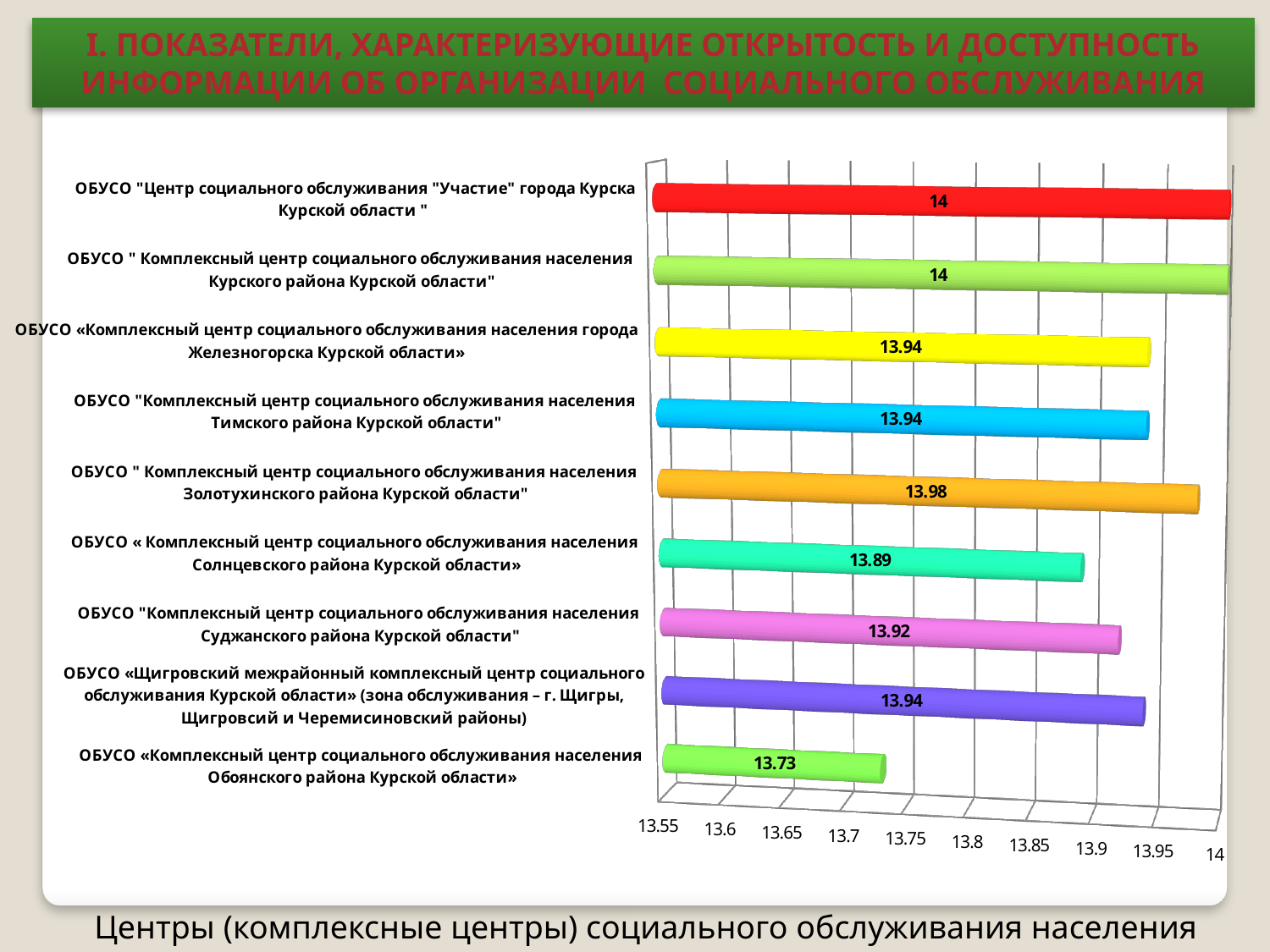
What kind of chart is shown on the slide? Bar chart What is the value for ОБУСО "Комплексный центр социального обслуживания населения Суджанского района Курской области"? 13.92 What is the value for ОБУСО «Комплексный центр социального обслуживания населения Обоянского района Курской области»? 13.73 Which has a larger value: the Золотухинского района centre or the Суджанского района centre? Золотухинского района How many organisations are shown in the chart? 9 What is the value for ОБУСО «Комплексный центр социального обслуживания населения Солнцевского района Курской области»? 13.89 What is the value for ОБУСО "Комплексный центр социального обслуживания населения Золотухинского района Курской области"? 13.98 Is the value for the Солнцевского района centre greater or less than 13.85? greater Which organisation has the lowest value in the chart? ОБУСО «Комплексный центр социального обслуживания населения Обоянского района Курской области» What is the difference between the value for ОБУСО "Центр социального обслуживания "Участие" города Курска Курской области" and the value for ОБУСО «Комплексный центр социального обслуживания населения Обоянского района Курской области»? 0.27 What is the highest value shown in the chart? 14 What colour is the bar for ОБУСО "Центр социального обслуживания "Участие" города Курска Курской области"? Red